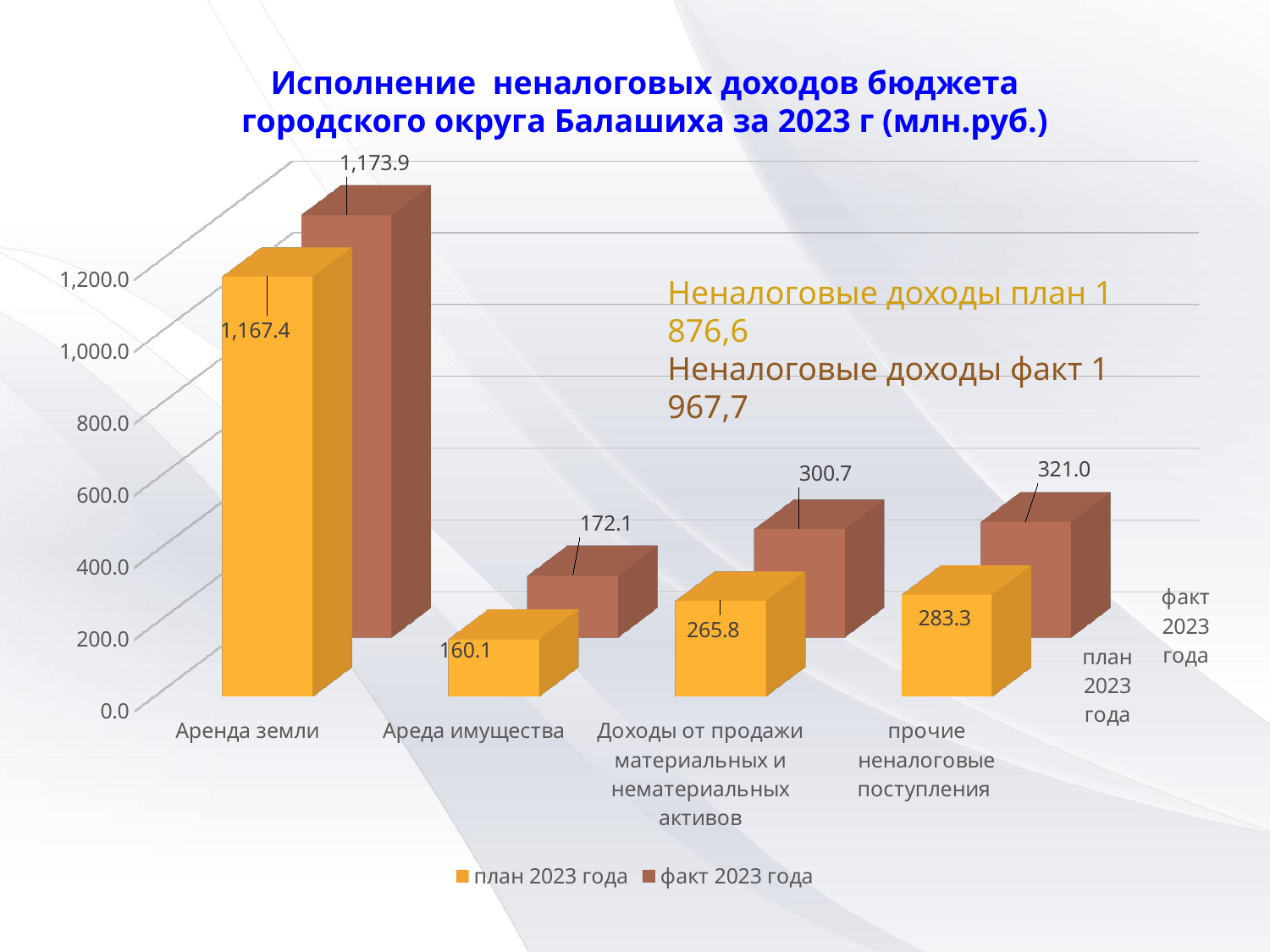
What is the difference between the факт 2023 года and план 2023 года values for Доходы от продажи материальных и нематериальных активов? 34.9 What is the total of the план 2023 года and факт 2023 года values for Ареда имущества? 332.2 How many categories are shown on the x axis? 4 What is the факт 2023 года value for Ареда имущества? 172.1 What kind of chart is shown on the slide? bar chart Which is larger for прочие неналоговые поступления: план 2023 года or факт 2023 года? факт 2023 года How many series does the legend list? 2 What is the факт 2023 года value for Аренда земли? 1,173.9 What is the план 2023 года value for прочие неналоговые поступления? 283.3 What is the план 2023 года value for Аренда земли? 1,167.4 Which category has the highest факт 2023 года value? Аренда земли Which category has the lowest план 2023 года value? Ареда имущества